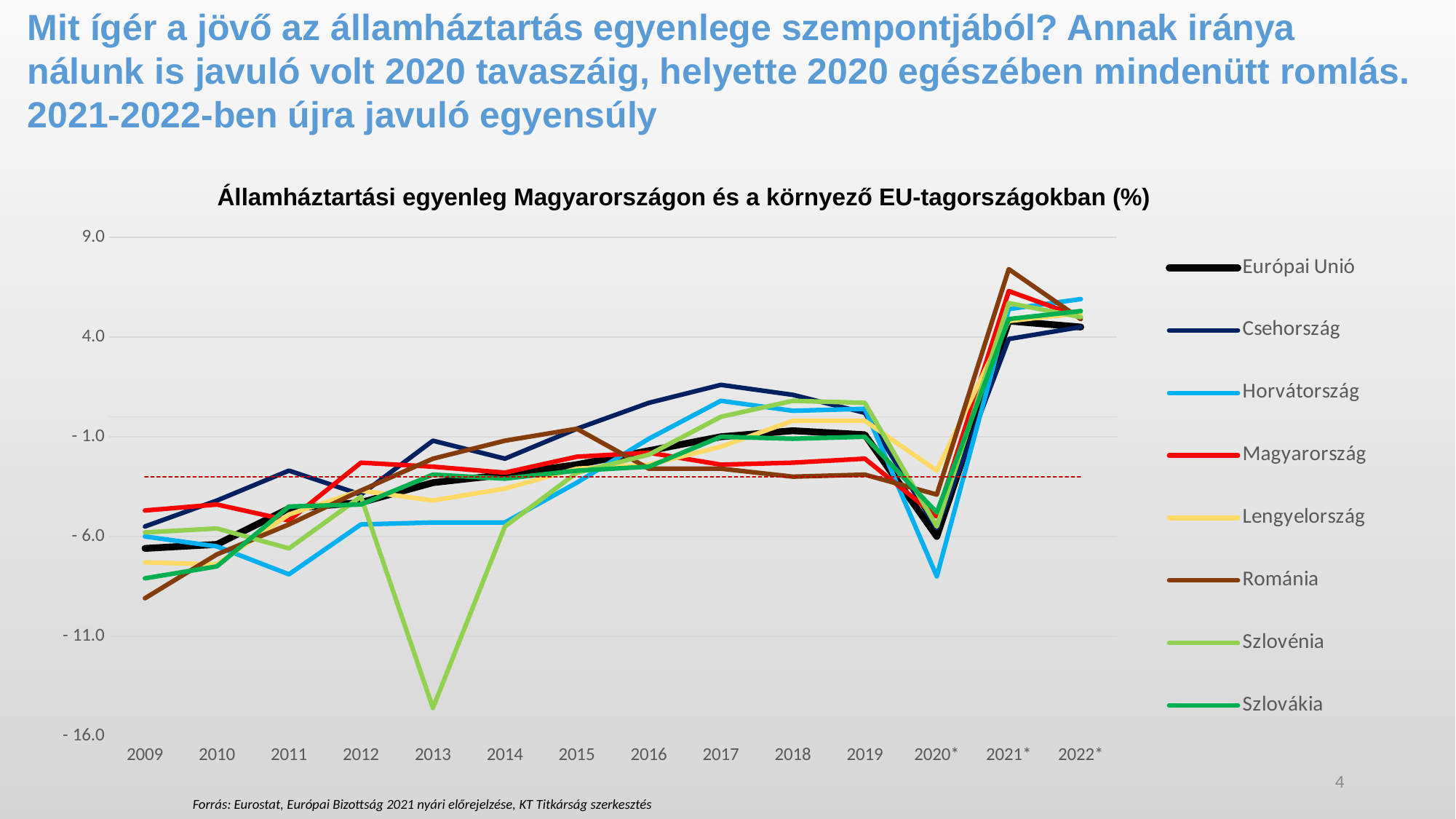
What kind of chart is shown on the slide? line chart Which series has the lowest value in 2020*? Horvátország What is the title of the chart? Államháztartási egyenleg Magyarországon és a környező EU-tagországokban (%) Is the value for Románia in 2021* greater or less than 4.0? greater Which series has the highest value in 2021*? Románia Does the value for Szlovénia rise or fall from 2013 to 2017? rise Is the value for Horvátország in 2020* greater or less than -6.0? less Is the value for Szlovénia in 2013 greater or less than -11.0? less Which series has the lowest value in 2013? Szlovénia How many series does the legend list? 8 In 2020*, which is larger: the value for Románia or the value for Horvátország? Románia How many years are shown along the x axis? 14